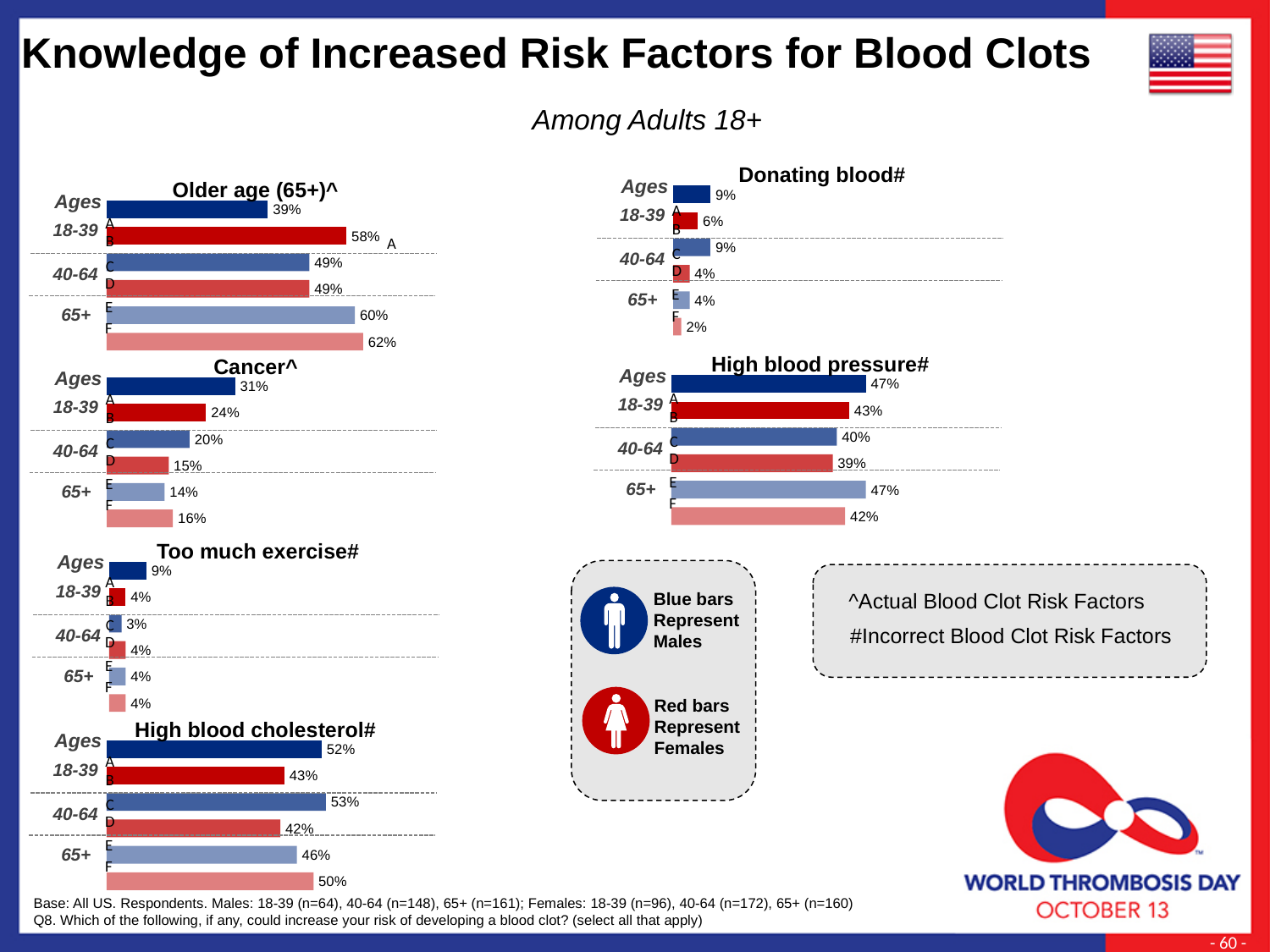
According to the legend, what do the red bars represent? Females In the 'Older age (65+)^' chart, what percentage of females aged 18-39 identified older age as a risk factor? 58% In the 'Cancer^' chart, what is the difference between males aged 18-39 and females aged 18-39? 7% In the 'High blood cholesterol#' chart, which is larger: males aged 40-64 or females aged 40-64? Males aged 40-64 (53%) In the 'High blood pressure#' chart, what is the difference between males aged 65+ and females aged 65+? 5% In the 'Cancer^' chart, which group has the highest value? Males 18-39 (31%) In the 'Donating blood#' chart, which group has the lowest value? Females 65+ (2%) In the 'High blood pressure#' chart, what is the value for males aged 40-64? 40% In the 'High blood cholesterol#' chart, what is the value for females aged 65+? 50% In the 'Too much exercise#' chart, what is the value for males aged 40-64? 3% What type of chart is used for 'Donating blood#'? Bar chart In the 'Older age (65+)^' chart, what is the value for males aged 65+? 60%